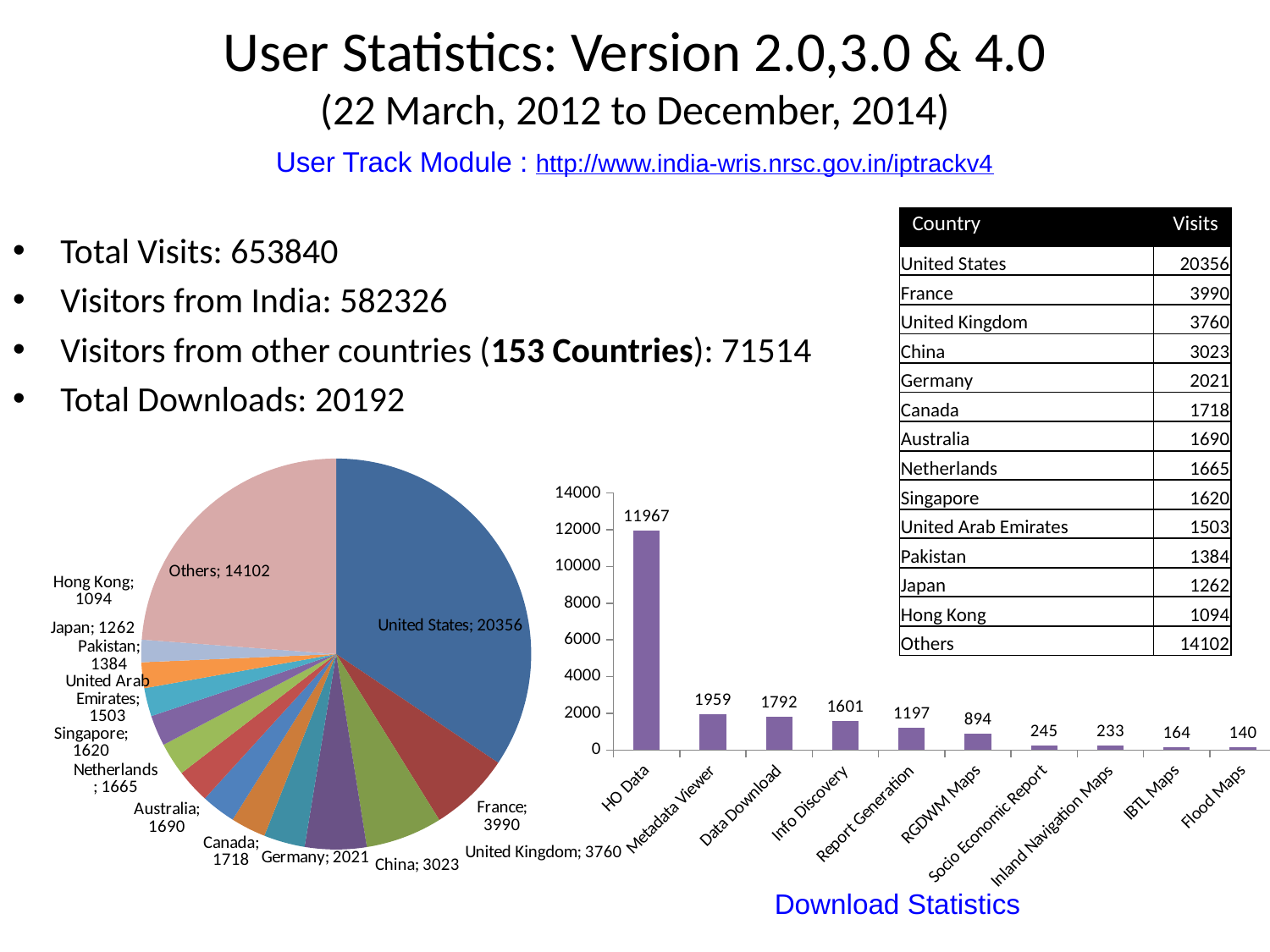
In the Download Statistics bar chart, what is the difference between HO Data and Metadata Viewer? 10008 In the Download Statistics bar chart, what is the value for Flood Maps? 140 In the Download Statistics bar chart, which category has the lowest value? Flood Maps In the Download Statistics bar chart, what is the value for HO Data? 11967 In the Download Statistics bar chart, how many categories are shown on the x axis? 10 In the Download Statistics bar chart, do the values rise or fall from left to right along the x axis? Fall What kind of chart is the Download Statistics chart? Bar chart In the pie chart on the left, which is larger, France or United Kingdom? France In the pie chart on the left, what is the value for Germany? 2021 In the pie chart on the left, how many slices are there? 14 In the Download Statistics bar chart, which category has the highest value? HO Data In the pie chart on the left, which slice is the largest? United States